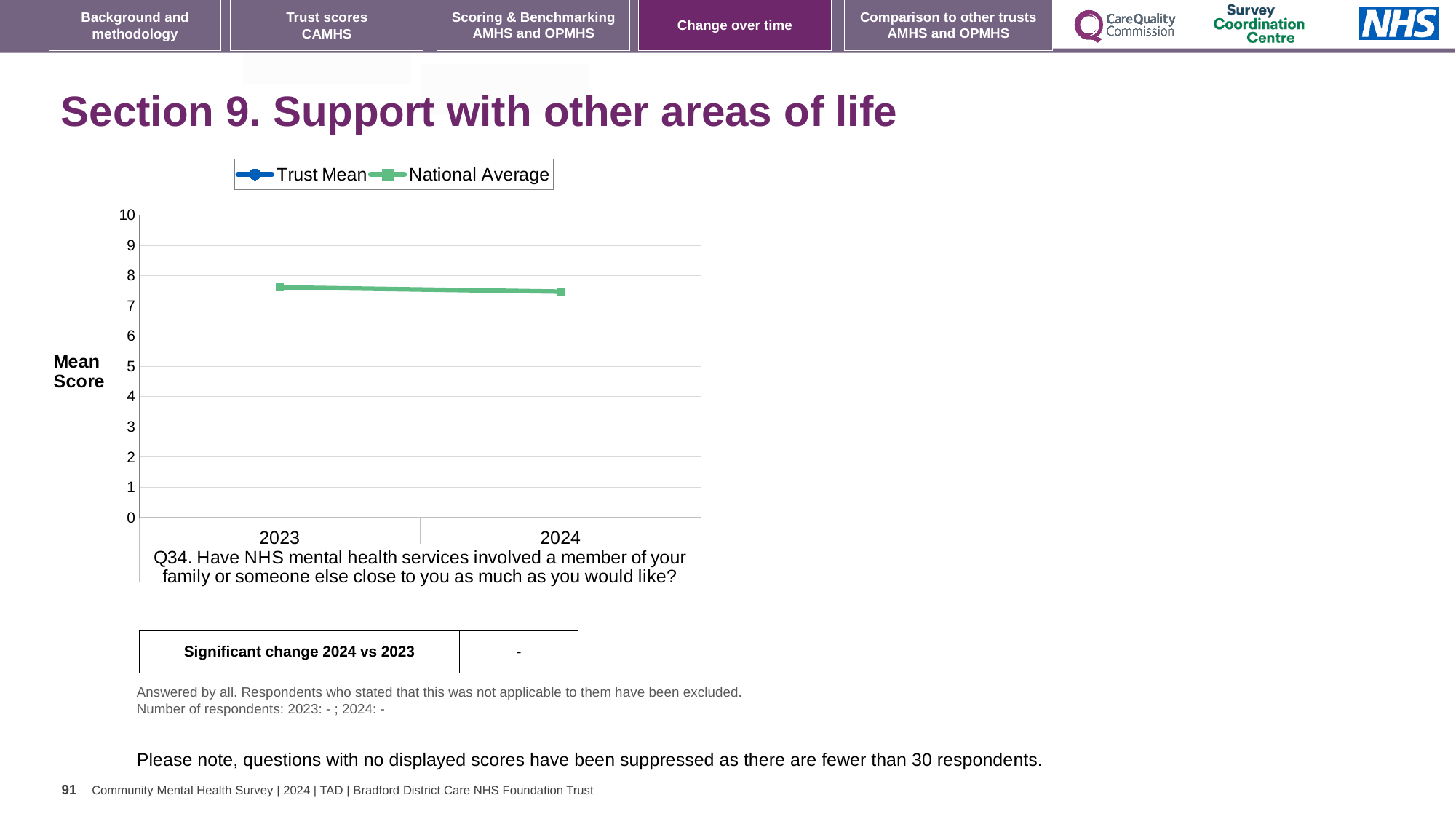
Is the National Average value for 2023 greater or less than 8? less Is the National Average value for 2024 greater or less than 8? less How many years are shown on the x axis of the chart? 2 Which two series are listed in the chart legend? Trust Mean and National Average Does the National Average line rise or fall from 2023 to 2024? fall Is the National Average value for 2023 greater or less than 7? greater How many series does the chart legend list? 2 Which years are shown on the x axis of the chart? 2023 and 2024 What is the maximum value shown on the y axis of the chart? 10 What kind of chart is shown on the slide? line chart